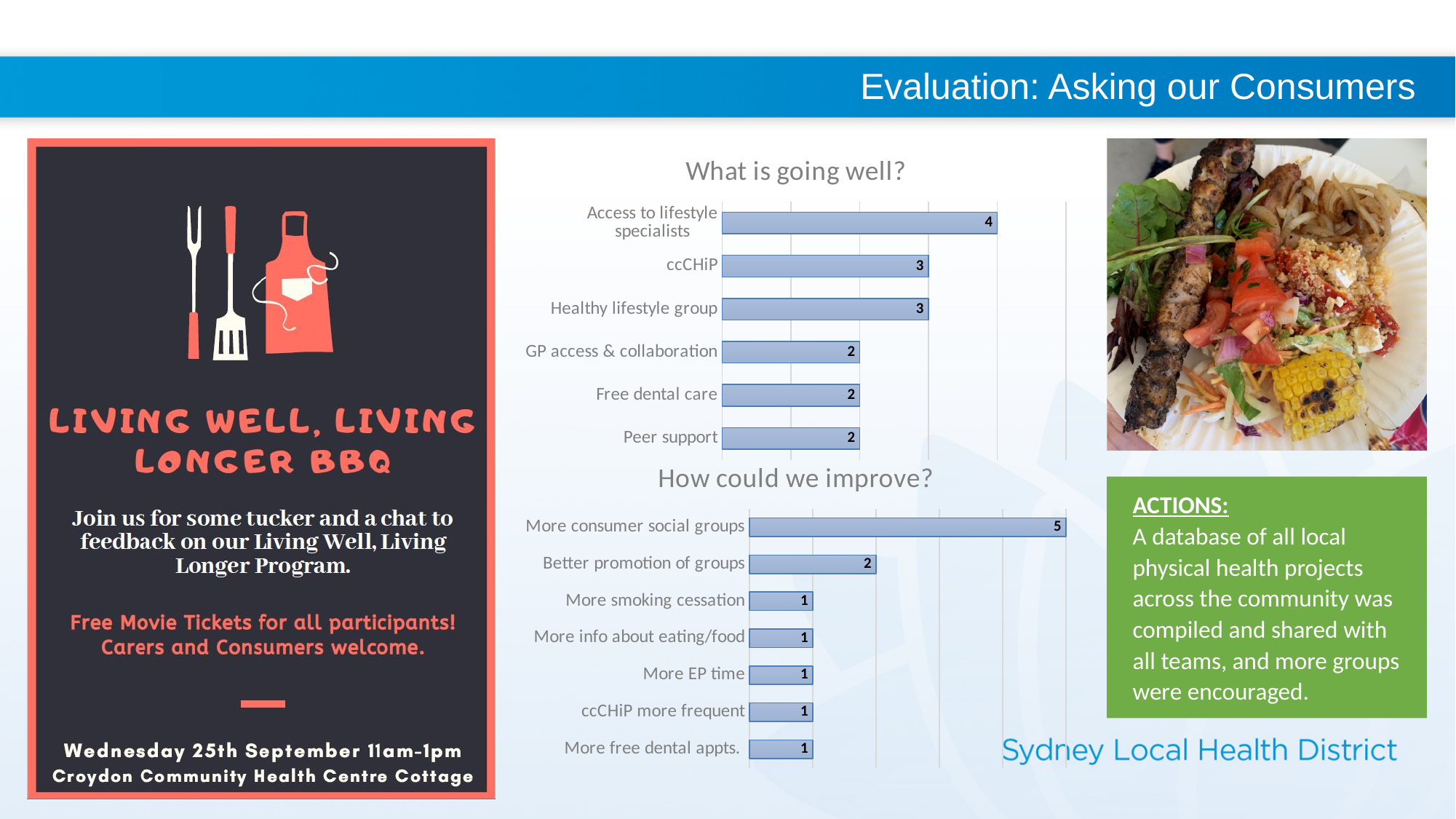
In the 'What is going well?' chart, what is the difference between Access to lifestyle specialists and Peer support? 2 In the 'How could we improve?' chart, how many categories are shown? 7 In the 'What is going well?' chart, which category has the highest value? Access to lifestyle specialists In the 'What is going well?' chart, how many categories are shown? 6 In the 'What is going well?' chart, what is the value for Access to lifestyle specialists? 4 In the 'What is going well?' chart, what is the value for Free dental care? 2 In the 'How could we improve?' chart, what is the difference between More consumer social groups and Better promotion of groups? 3 In the 'How could we improve?' chart, what is the value for Better promotion of groups? 2 In the 'How could we improve?' chart, what is the value for More consumer social groups? 5 In the 'How could we improve?' chart, which is larger: More consumer social groups or More EP time? More consumer social groups What type of chart is the 'What is going well?' chart? Bar chart In the 'How could we improve?' chart, which category has the highest value? More consumer social groups